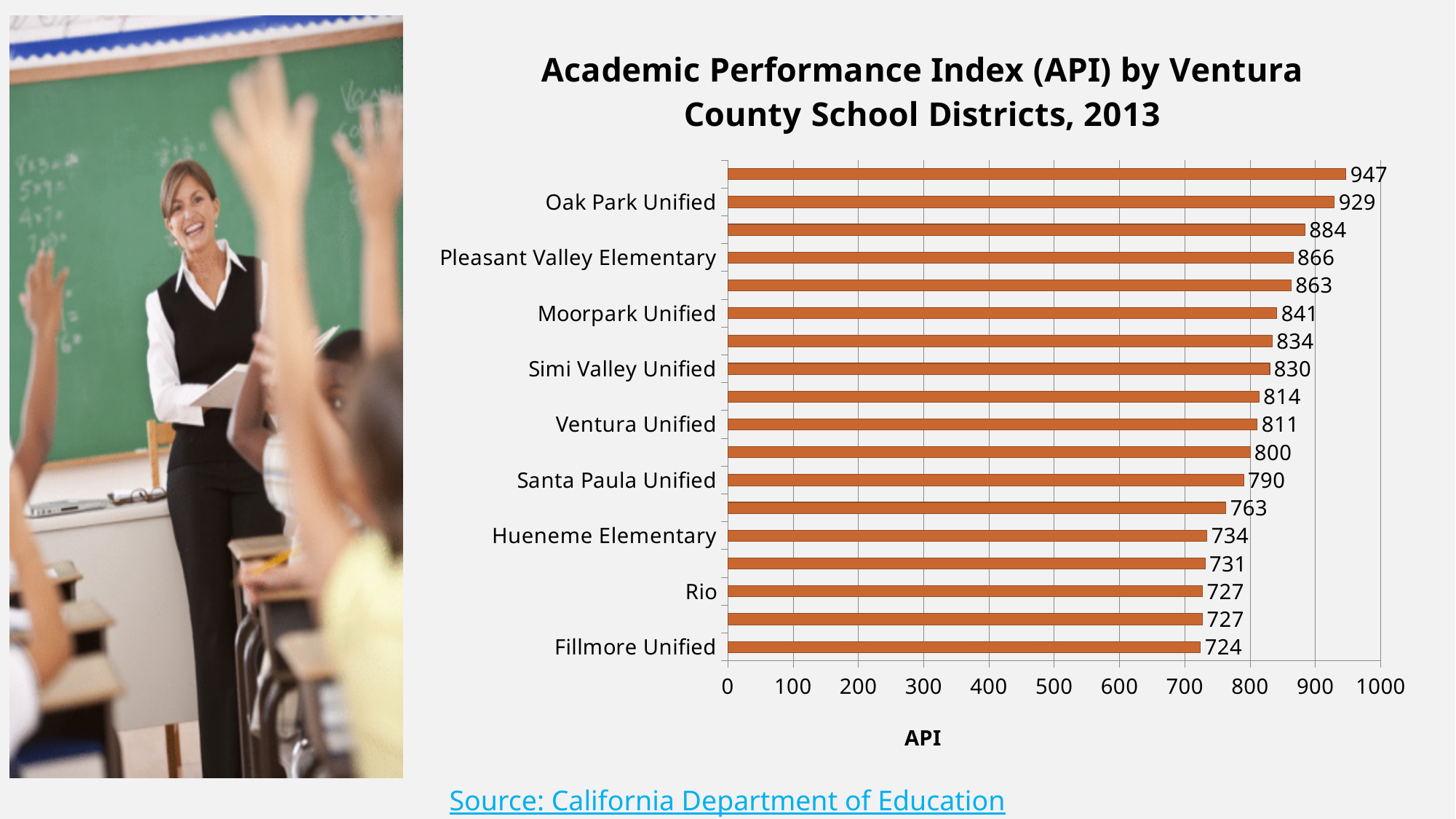
What kind of chart is shown on the slide? Bar chart What is the API value for Fillmore Unified? 724 What is the API value for Oak Park Unified? 929 What is the difference in API between Pleasant Valley Elementary and Simi Valley Unified? 36 How many bars are plotted on the chart? 18 What is the highest API value shown on the chart? 947 Which has a higher API, Ventura Unified or Santa Paula Unified? Ventura Unified Which labeled district has the lowest API value? Fillmore Unified What is the API value for Moorpark Unified? 841 What is the API value for Hueneme Elementary? 734 What is the difference in API between Oak Park Unified and Fillmore Unified? 205 Is the API value for Rio greater or less than 800? less